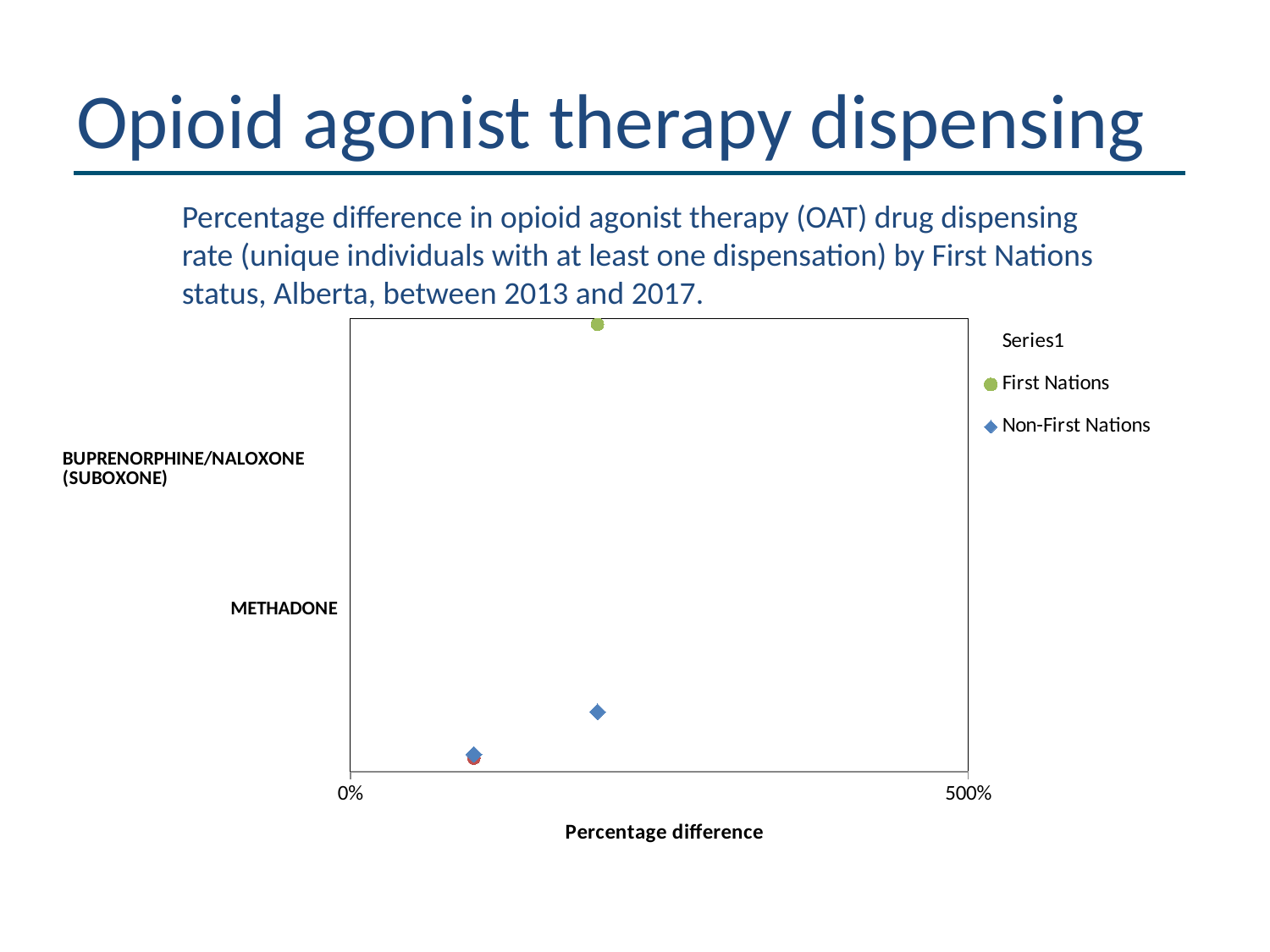
Is the value of the green First Nations point greater or less than 0%? greater Are all the plotted points in the chart greater or less than 500%? less What is the highest value shown on the horizontal axis of the chart? 500% What are the two drug categories labelled on the vertical axis of the chart? Buprenorphine/Naloxone (Suboxone) and Methadone Is the value of the green First Nations point greater or less than 500%? less Which legend entry is represented by a blue diamond marker? Non-First Nations How many drug categories are labelled on the vertical axis of the chart? 2 What kind of chart is shown on the slide? scatter chart What is the label of the horizontal axis of the chart? Percentage difference How many entries does the chart legend list? 3